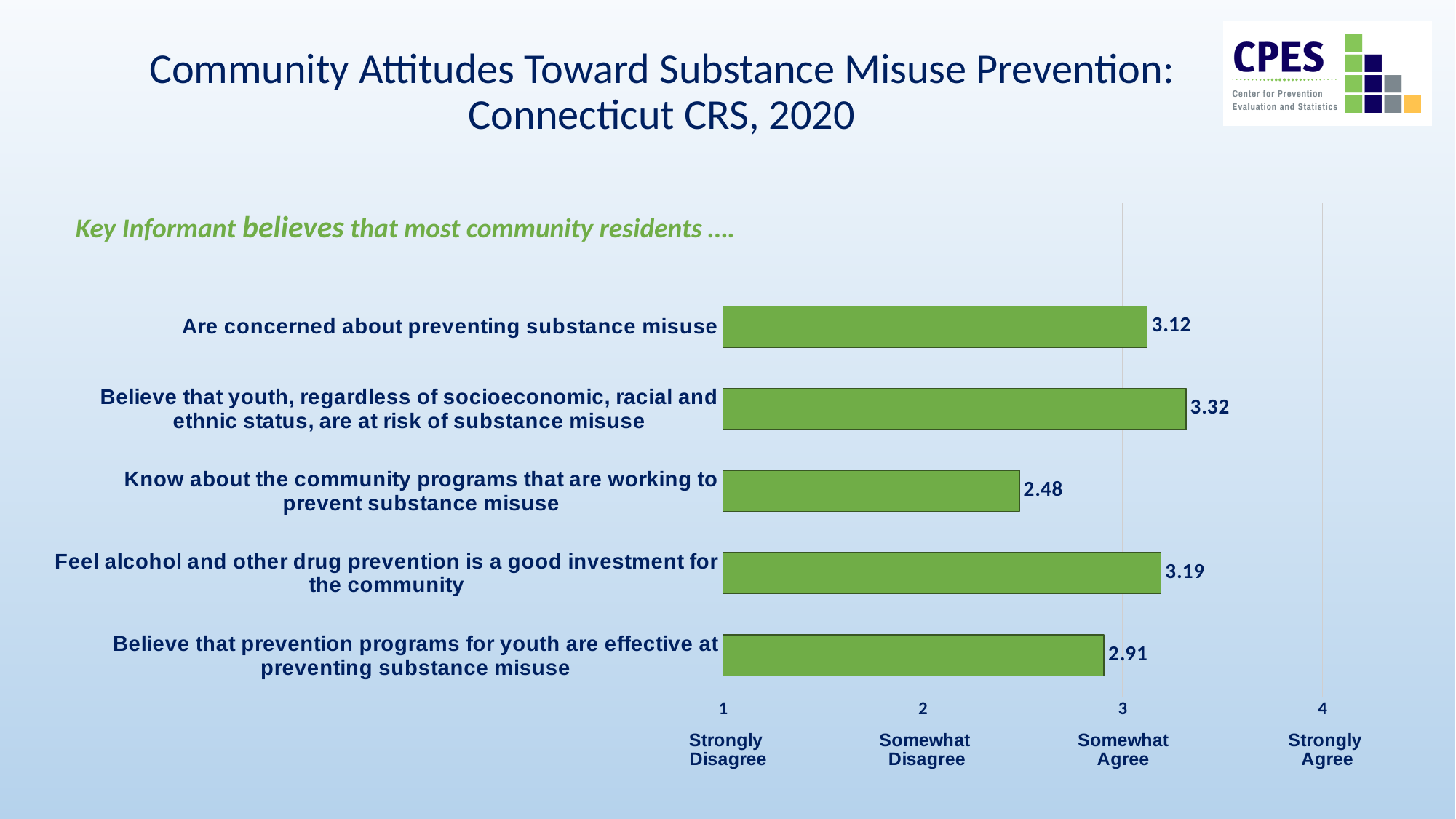
What is the difference between the value for "Believe that youth, regardless of socioeconomic, racial and ethnic status, are at risk of substance misuse" and the value for "Know about the community programs that are working to prevent substance misuse"? 0.84 Which category has the lowest value? Know about the community programs that are working to prevent substance misuse What colour are the bars in the chart? green What kind of chart is shown on the slide? bar chart What is the value for "Are concerned about preventing substance misuse"? 3.12 Which is larger: the value for "Feel alcohol and other drug prevention is a good investment for the community" or the value for "Are concerned about preventing substance misuse"? Feel alcohol and other drug prevention is a good investment for the community What is the value for "Believe that prevention programs for youth are effective at preventing substance misuse"? 2.91 Which category has the highest value? Believe that youth, regardless of socioeconomic, racial and ethnic status, are at risk of substance misuse Is the value for "Believe that prevention programs for youth are effective at preventing substance misuse" greater or less than 3? less What is the value for "Know about the community programs that are working to prevent substance misuse"? 2.48 What label does the x axis show at the value 4? Strongly Agree How many categories are shown in the chart? 5